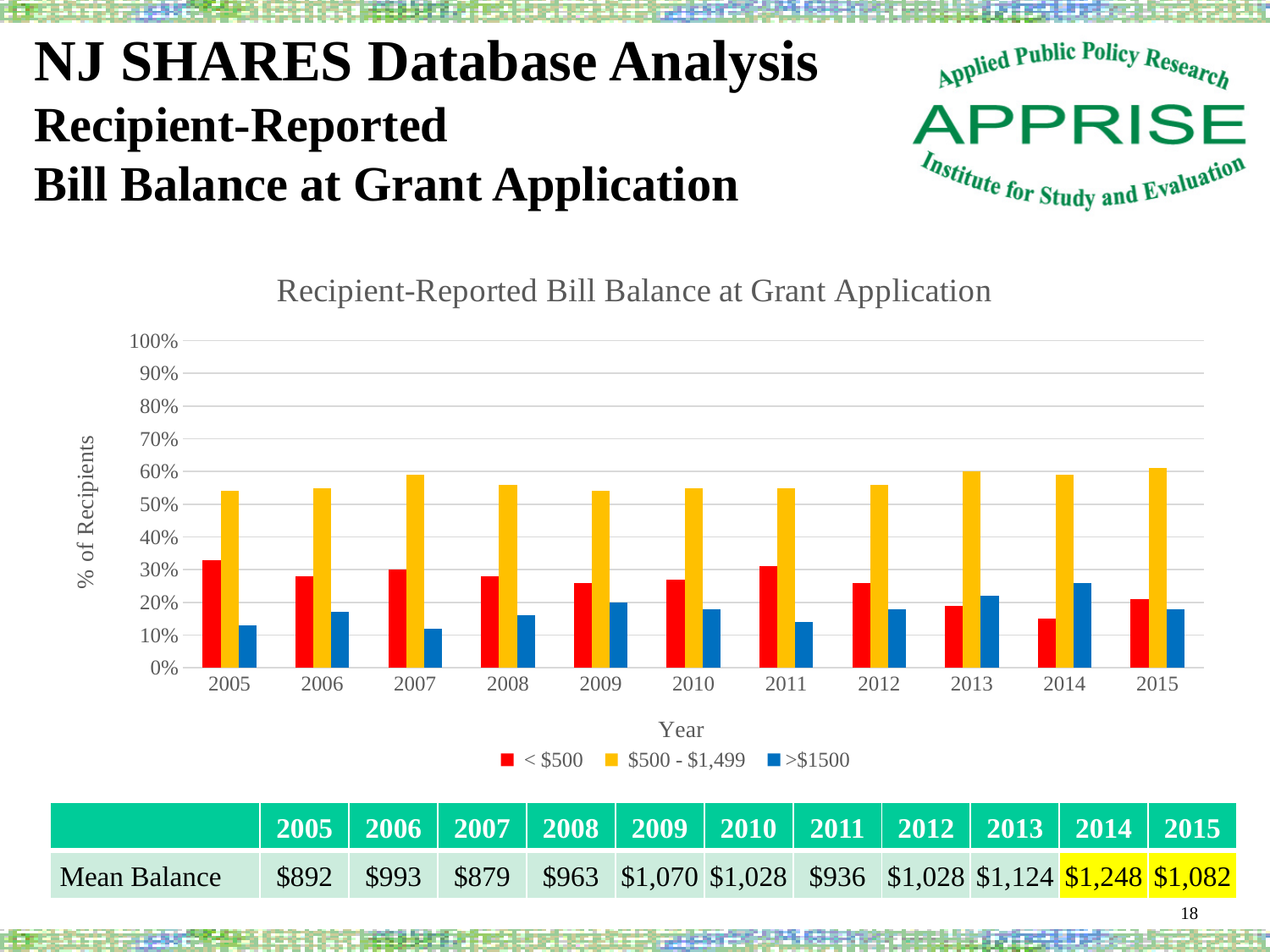
Is the value for < $500 in 2005 greater or less than 30%? greater What is the label on the vertical axis of the chart? % of Recipients Is the value for >$1500 in 2007 greater or less than 20%? less In which year is the < $500 bar the tallest? 2005 Is the value for $500 - $1,499 in 2013 greater or less than 50%? greater What kind of chart is shown on the slide? bar chart In 2014, which is larger: the < $500 bar or the >$1500 bar? >$1500 In which year is the >$1500 bar the tallest? 2014 How many years are shown along the x axis of the chart? 11 In which year is the < $500 bar the shortest? 2014 How many series does the chart legend list? 3 Which series has the tallest bar in every year of the chart? $500 - $1,499